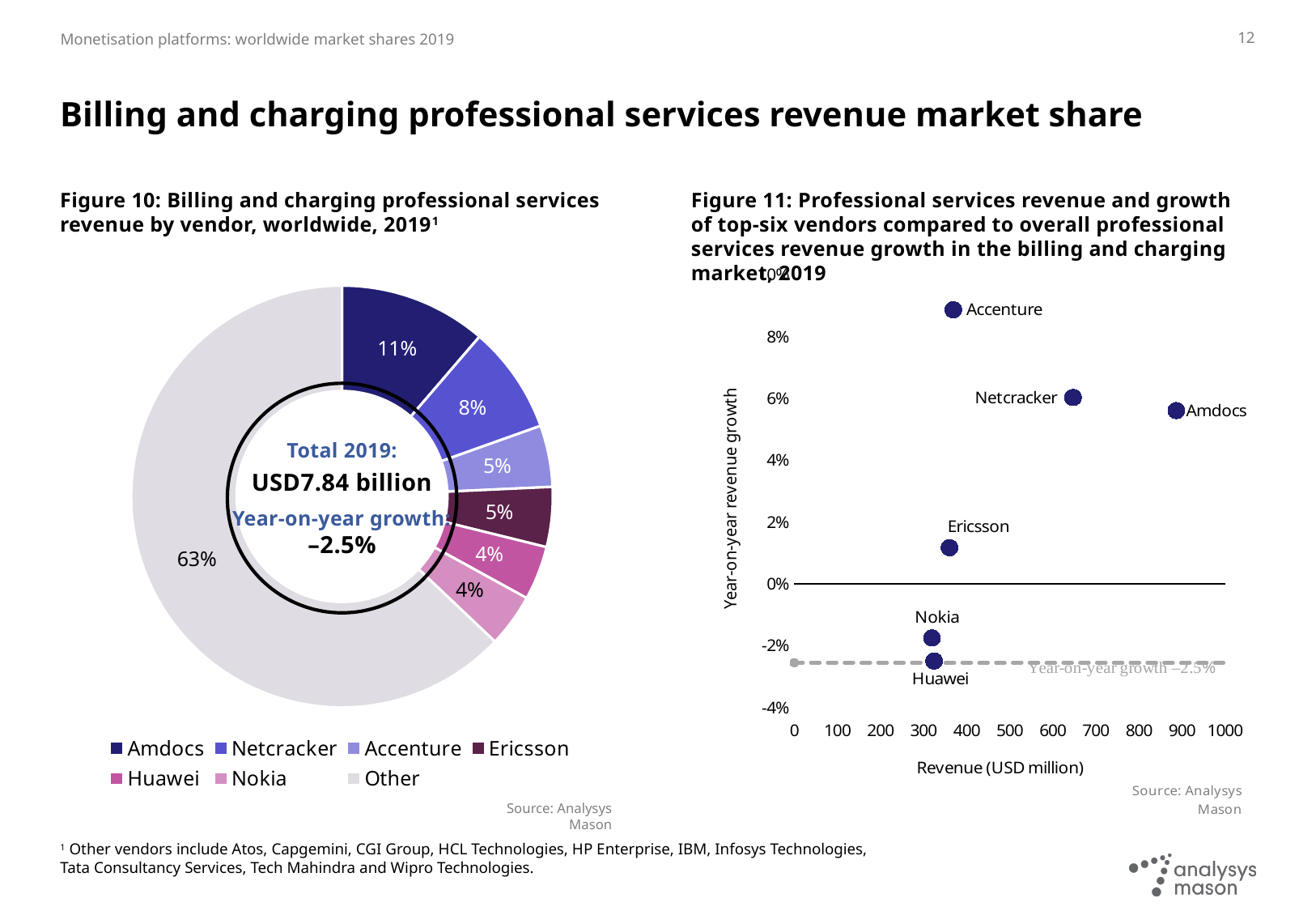
How many vendors are plotted in Figure 11? 6 What total 2019 revenue is shown in the centre of Figure 10? USD7.84 billion What kind of chart is Figure 10? doughnut chart In Figure 11, is the revenue for Amdocs greater or less than 800 USD million? greater In Figure 10, what share is labelled for Other? 63% In Figure 10, which vendor has the largest share? Other In Figure 10, what share of billing and charging professional services revenue does Amdocs hold? 11% In Figure 10, which has the larger share, Netcracker or Accenture? Netcracker In Figure 10, how many percentage points larger is Amdocs's share than Netcracker's? 3 percentage points How many entries does the legend of Figure 10 list? 7 What kind of chart is Figure 11? scatter chart In Figure 11, which vendor has the highest year-on-year revenue growth? Accenture